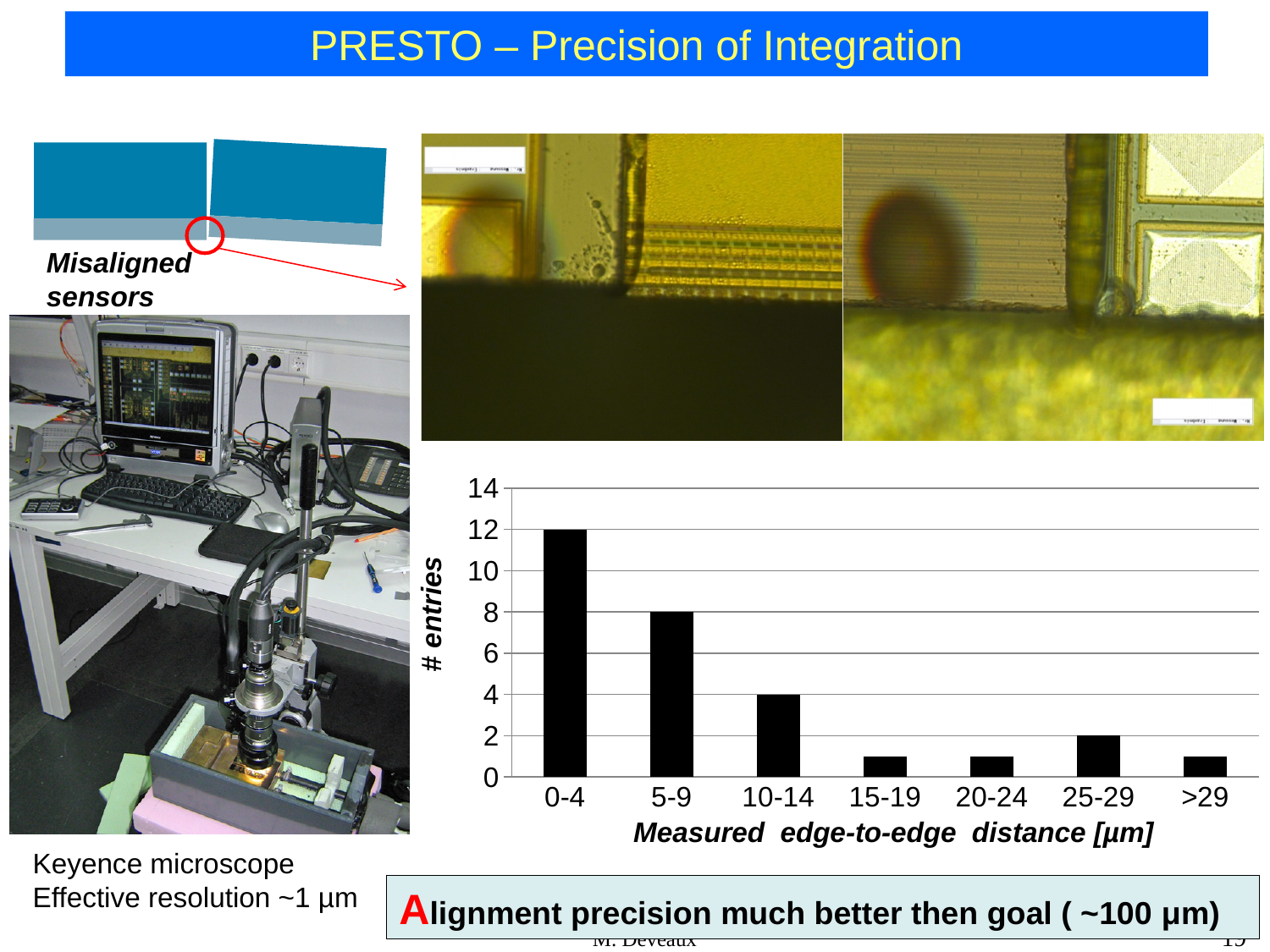
Do the number of entries generally rise or fall as the measured edge-to-edge distance increases? fall How many entries are in the 10-14 µm category? 4 Is the number of entries for the 15-19 category greater or less than 2? less How many entries are in the 5-9 µm category? 8 What kind of chart is shown on the slide? bar chart Which category has more entries, 10-14 or 25-29? 10-14 How many distance categories are shown on the x axis of the chart? 7 How many entries are in the 0-4 µm category? 12 What is the label of the y axis of the chart? # entries What is the difference in entries between the 0-4 and 5-9 categories? 4 How many entries are in the 25-29 µm category? 2 Which measured edge-to-edge distance category has the highest number of entries? 0-4